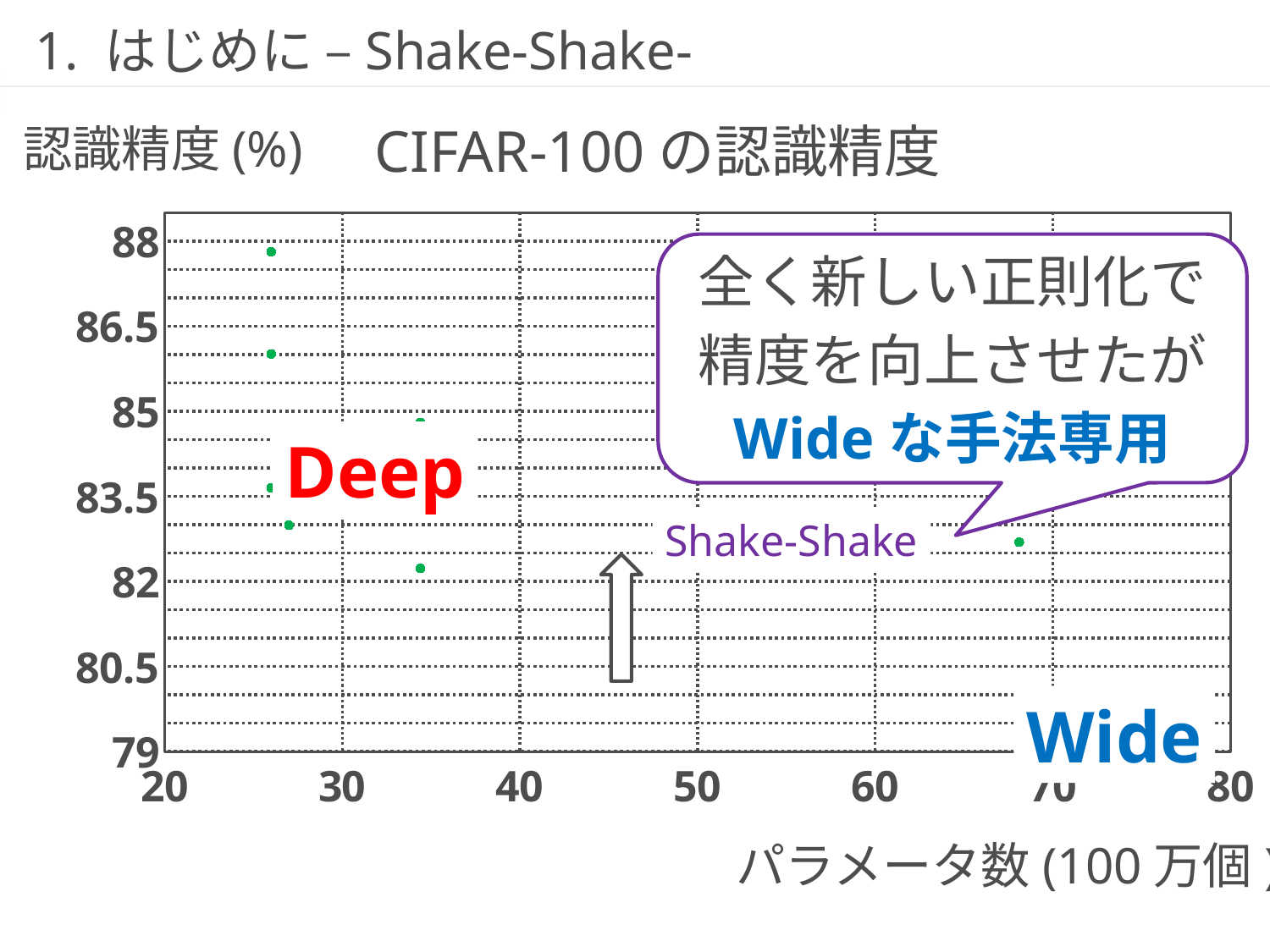
Is the accuracy of the highest point on the chart greater or less than 86.5? greater Which has more parameters: the point labelled Shake-Shake or the points in the Deep group near x = 30? Shake-Shake What kind of chart is shown on the slide? scatter plot What is the title of the chart? CIFAR-100 の認識精度 Is the accuracy of the point labelled Shake-Shake greater or less than 82? greater Is the parameter count of the point labelled Shake-Shake greater or less than 60? greater What is the largest value shown on the x axis? 80 What is the label of the x axis? パラメータ数 (100 万個) Which has higher accuracy: the topmost point near x = 26 or the point labelled Shake-Shake? the topmost point near x = 26